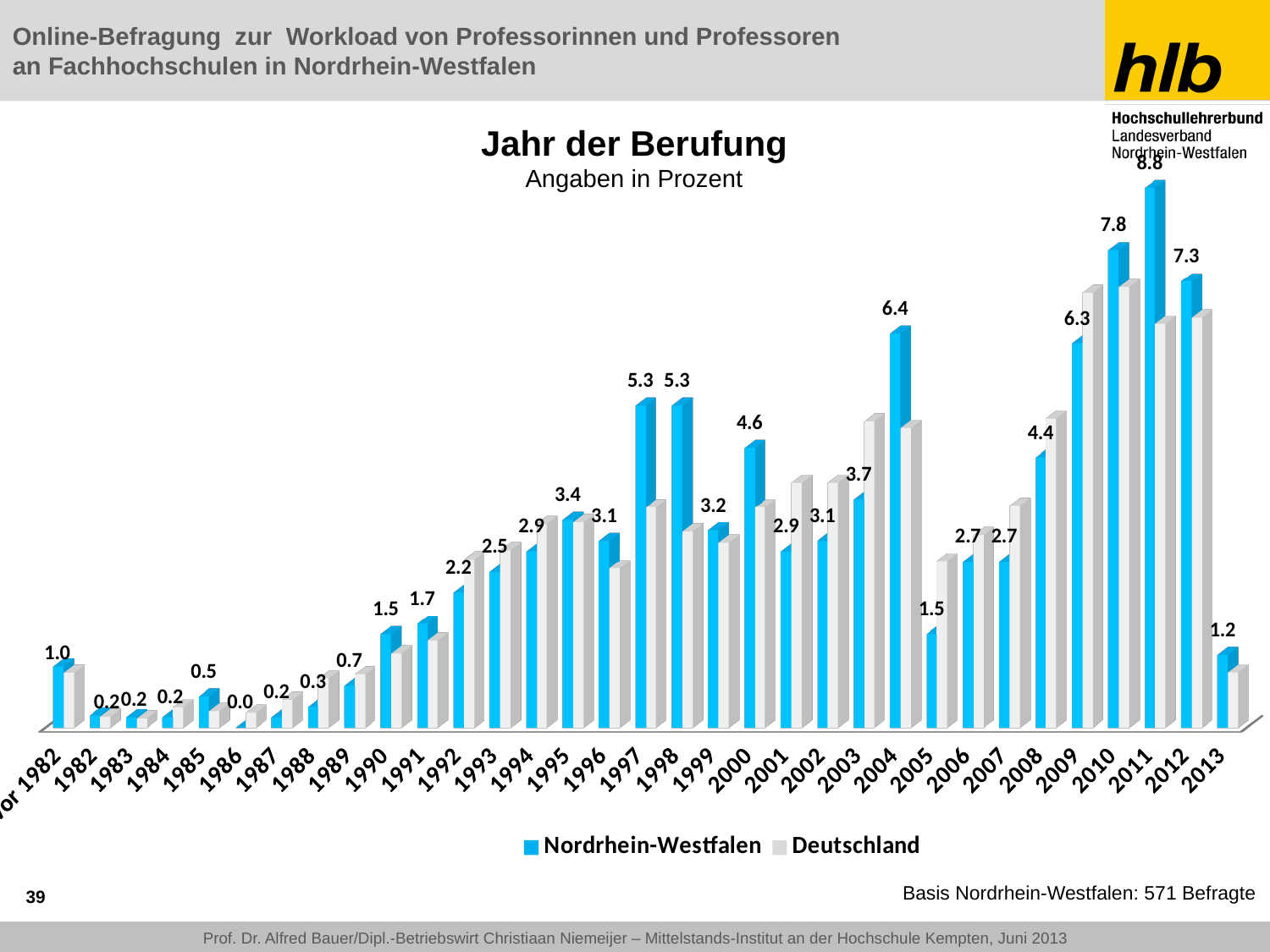
In 2003, which series has the larger value: Nordrhein-Westfalen or Deutschland? Deutschland What is the Nordrhein-Westfalen value for 1990? 1.5 What is the Nordrhein-Westfalen value for 2013? 1.2 What is the difference between the Nordrhein-Westfalen values for 2004 and 2005? 4.9 Which is larger for Nordrhein-Westfalen: the value for 2009 or the value for 2012? 2012 What is the Nordrhein-Westfalen value for 2004? 6.4 Which year has the highest Nordrhein-Westfalen value? 2011 How many series does the legend list? 2 Which year has the lowest Nordrhein-Westfalen value? 1986 What is the Nordrhein-Westfalen value for 2011? 8.8 What kind of chart is shown on the slide? Bar chart What is the difference between the Nordrhein-Westfalen values for 2011 and 2010? 1.0